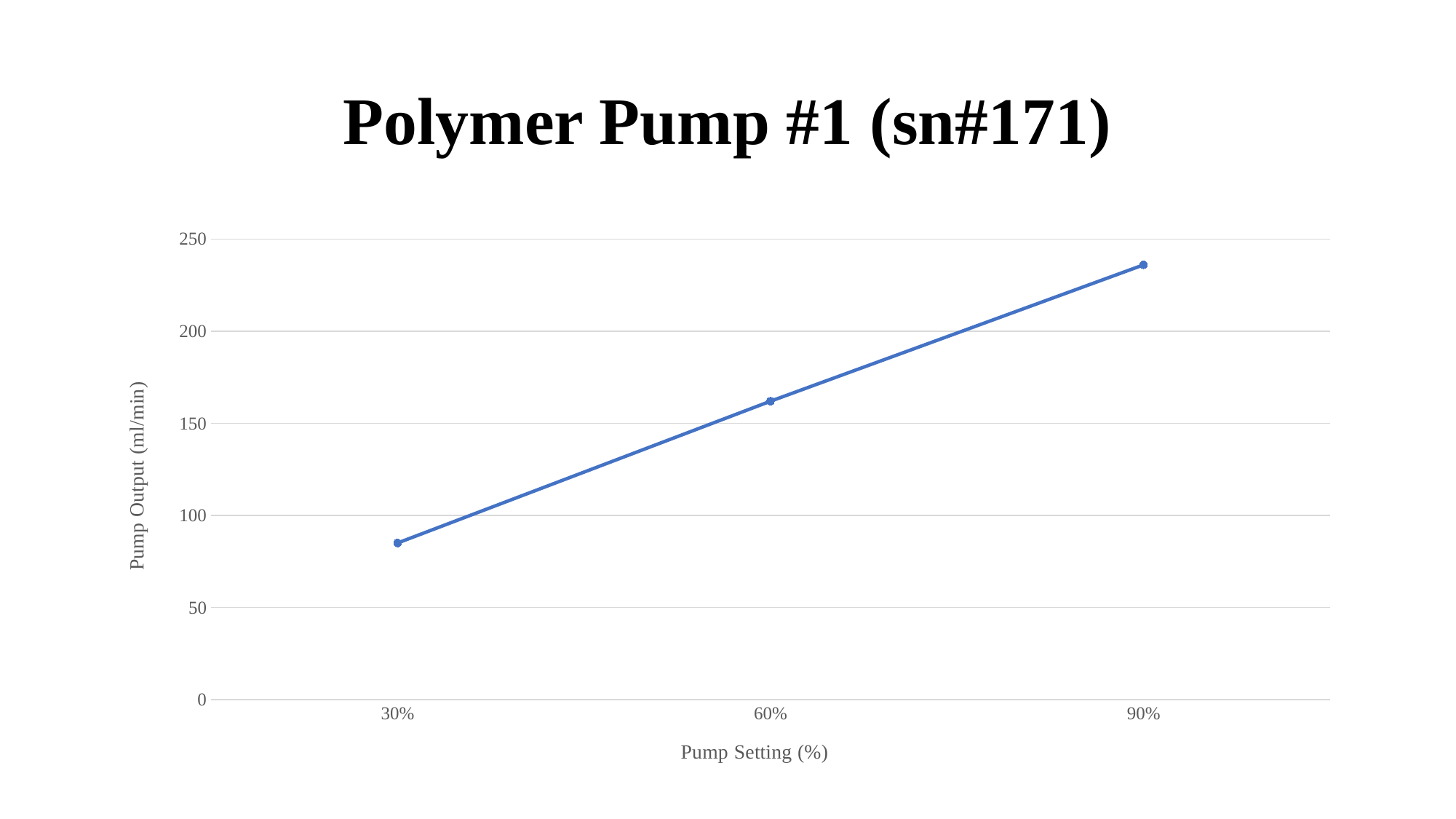
Is the pump output at 90% greater or less than 250 ml/min? less Does pump output rise or fall as the pump setting increases from 30% to 90%? rise Which pump setting has the lowest pump output? 30% Is the pump output at 30% greater or less than 100 ml/min? less What is the title of the chart? Polymer Pump #1 (sn#171) What is the label of the y axis? Pump Output (ml/min) Is the pump output at 60% greater or less than 150 ml/min? greater How many data points are plotted on the chart? 3 Which has the larger pump output, the 60% setting or the 30% setting? 60% Which pump setting has the highest pump output? 90% What kind of chart is shown on the slide? line chart